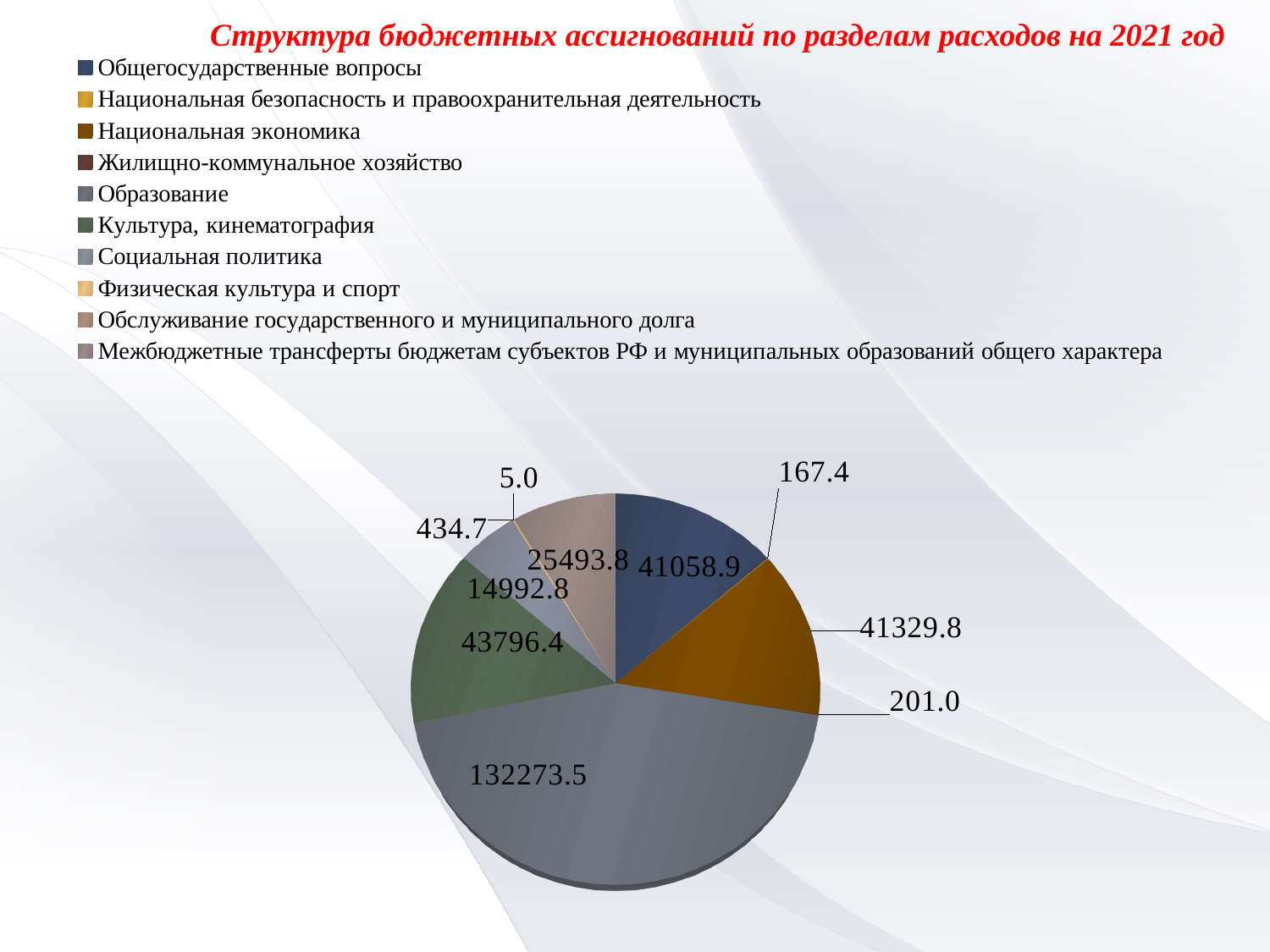
What is the value for Межбюджетные трансферты бюджетам субъектов РФ и муниципальных образований общего характера? 25493.8 What is the value for Образование? 132273.5 What is the value for Культура, кинематография? 43796.4 What is the smallest value labelled on the pie chart? 5.0 What is the title of the chart? Структура бюджетных ассигнований по разделам расходов на 2021 год How many categories does the pie chart have? 10 Which is larger, the value for Образование or the value for Общегосударственные вопросы? Образование What kind of chart is shown on the slide? pie chart What is the difference between the values for Образование and Культура, кинематография? 88477.1 Which category has the largest slice of the pie? Образование What is the value for Социальная политика? 14992.8 Which category is listed first in the legend? Общегосударственные вопросы